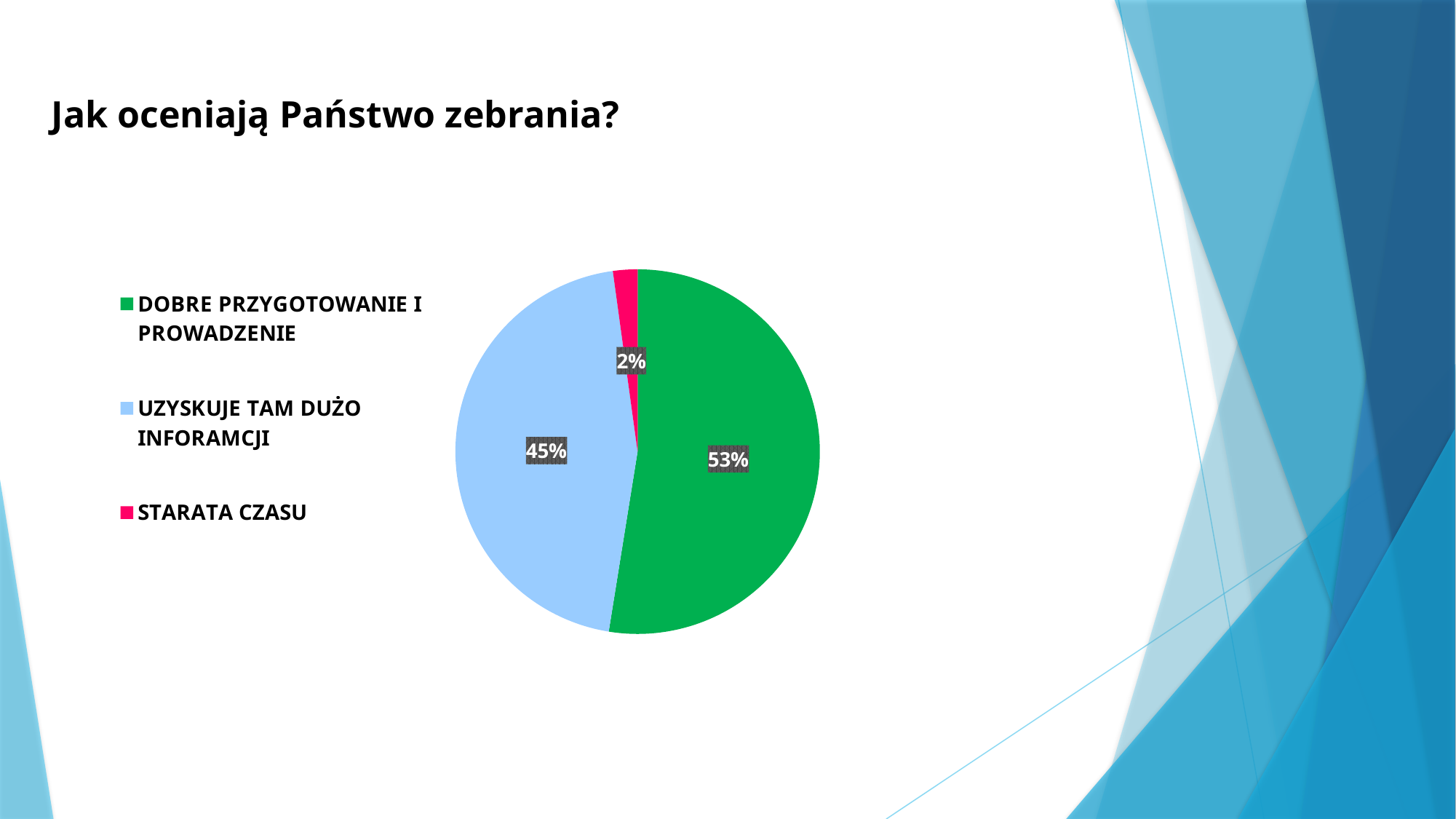
What is the difference in percentage points between UZYSKUJE TAM DUŻO INFORAMCJI and STARATA CZASU? 43 percentage points Which category has the smallest slice of the pie? STARATA CZASU What share of the pie does STARATA CZASU have? 2% What kind of chart is shown on the slide? Pie chart What share of the pie does DOBRE PRZYGOTOWANIE I PROWADZENIE have? 53% How many categories does the pie chart show? 3 What colour is the slice for STARATA CZASU? Pink Which is larger: the slice for DOBRE PRZYGOTOWANIE I PROWADZENIE or the slice for UZYSKUJE TAM DUŻO INFORAMCJI? DOBRE PRZYGOTOWANIE I PROWADZENIE What is the difference in percentage points between DOBRE PRZYGOTOWANIE I PROWADZENIE and UZYSKUJE TAM DUŻO INFORAMCJI? 8 percentage points Which category has the largest slice of the pie? DOBRE PRZYGOTOWANIE I PROWADZENIE What share of the pie does UZYSKUJE TAM DUŻO INFORAMCJI have? 45% What is the title of the slide containing the chart? Jak oceniają Państwo zebrania?